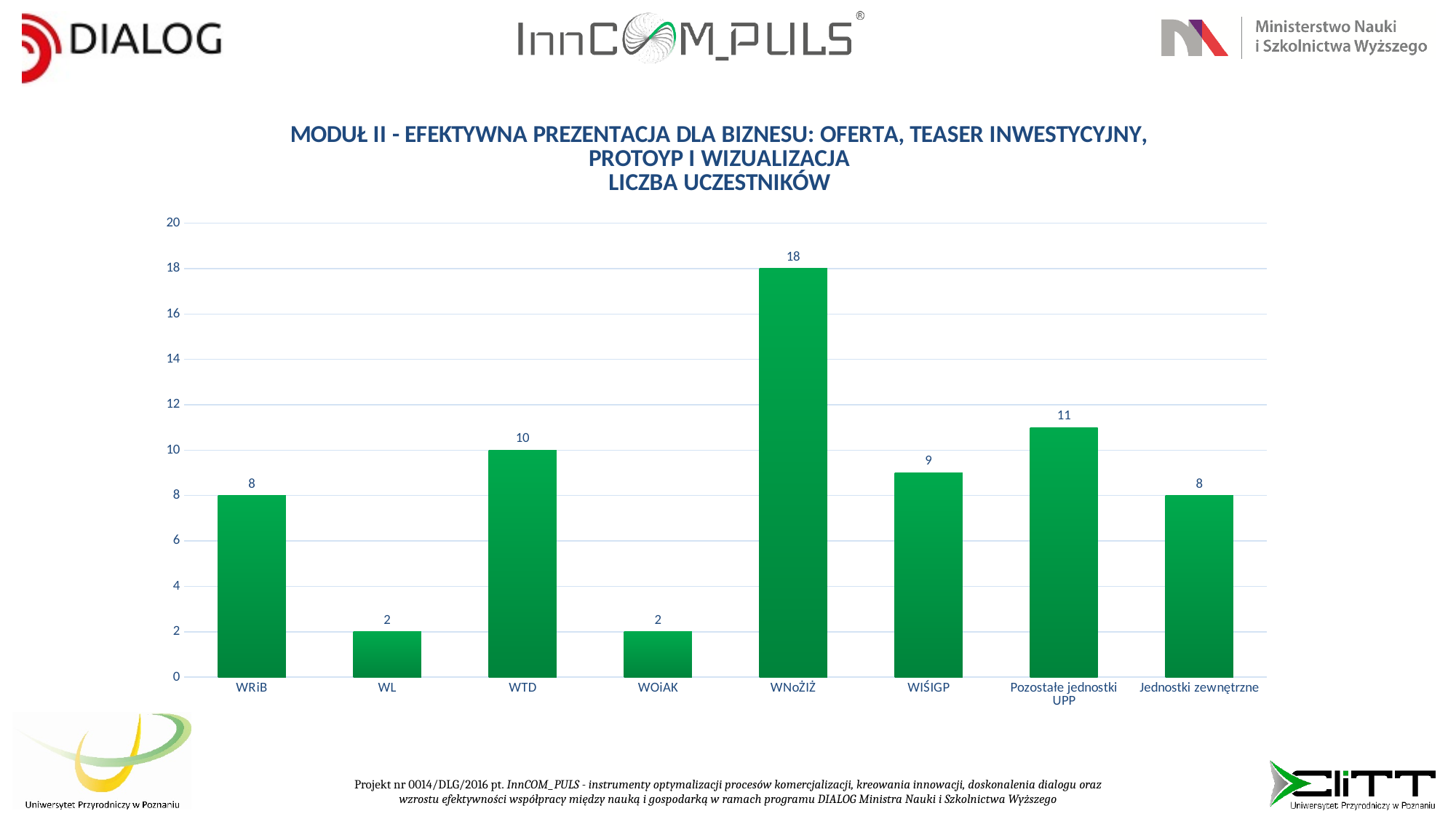
How many categories are shown on the x axis? 8 What is the total of the values for WRiB and Jednostki zewnętrzne? 16 Is the value for Jednostki zewnętrzne greater or less than 10? less What is the value shown for WTD? 10 Which is larger, the value for WTD or the value for WIŚIGP? WTD Which category has the highest number of participants? WNoŻiŻ What is the difference between the values for Pozostałe jednostki UPP and WRiB? 3 What kind of chart is shown on the slide? bar chart What is the difference between the values for WNoŻiŻ and WIŚIGP? 9 What is the value shown for Pozostałe jednostki UPP? 11 What is the number of participants for WNoŻiŻ? 18 Which categories have the lowest value on the chart? WL and WOiAK